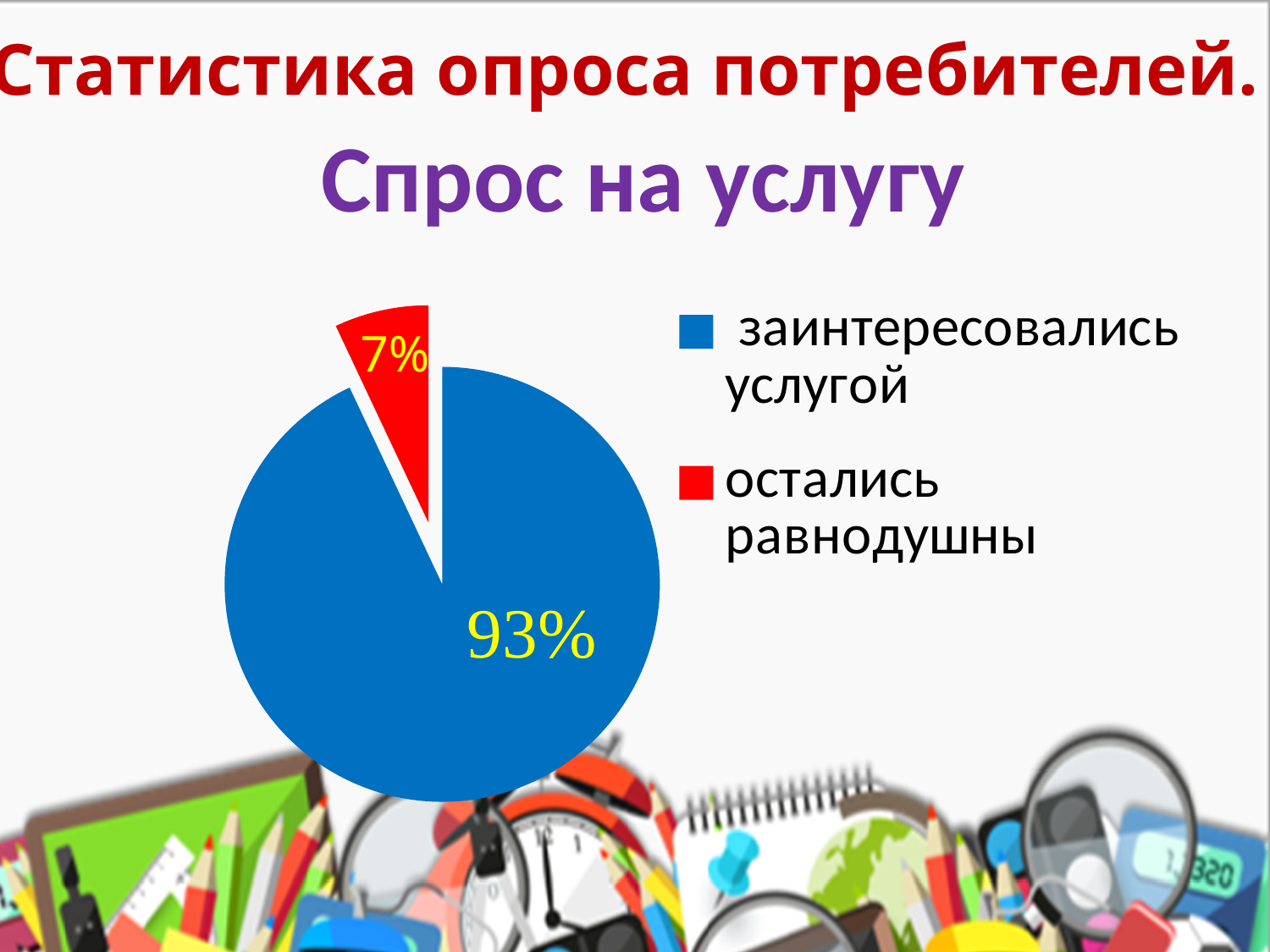
What share of the pie is labelled "заинтересовались услугой"? 93% Which is larger: the slice for "заинтересовались услугой" or the slice for "остались равнодушны"? заинтересовались услугой How many slices does the pie chart have? 2 What colour is the slice for "остались равнодушны"? red What is the title shown above the chart? Спрос на услугу What kind of chart is shown on the slide? pie chart What share of the pie is labelled "остались равнодушны"? 7% How many entries does the legend list? 2 What is the difference in percentage points between "заинтересовались услугой" and "остались равнодушны"? 86 Which category has the smallest slice of the pie? остались равнодушны Which category has the largest slice of the pie? заинтересовались услугой